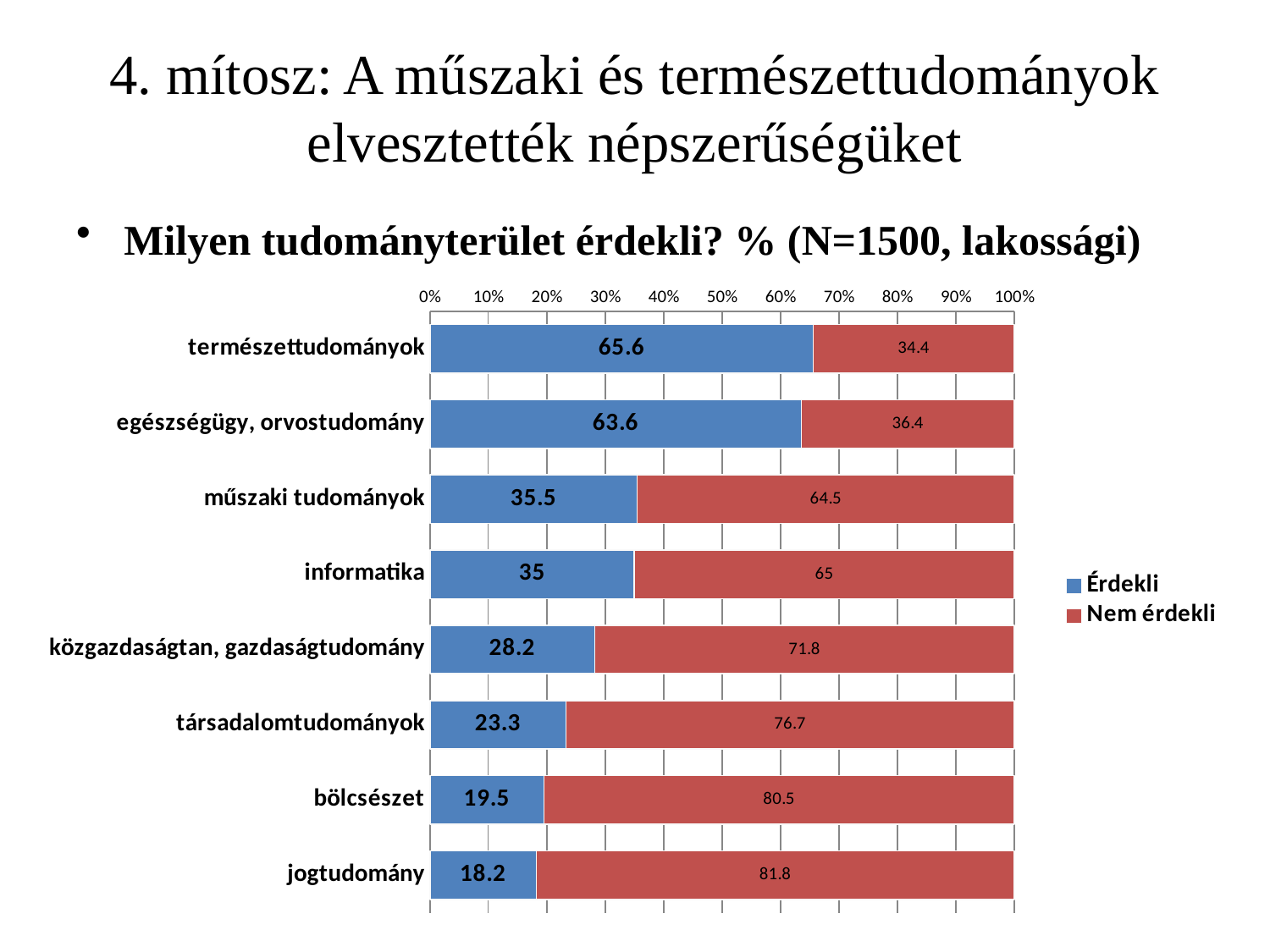
Which category has the highest "Érdekli" value? természettudományok What is the difference between the "Érdekli" values for természettudományok and műszaki tudományok? 30.1 Which category has the lowest "Érdekli" value? jogtudomány What is the total of the stacked bar for bölcsészet? 100 How many series does the legend list? 2 What is the "Érdekli" value for jogtudomány? 18.2 How many categories are shown on the chart? 8 What is the "Érdekli" value for természettudományok? 65.6 Which has a larger "Érdekli" value, közgazdaságtan, gazdaságtudomány or társadalomtudományok? közgazdaságtan, gazdaságtudomány What kind of chart is shown on the slide? stacked bar chart What is the "Nem érdekli" value for informatika? 65 Which colour represents the "Nem érdekli" series? red